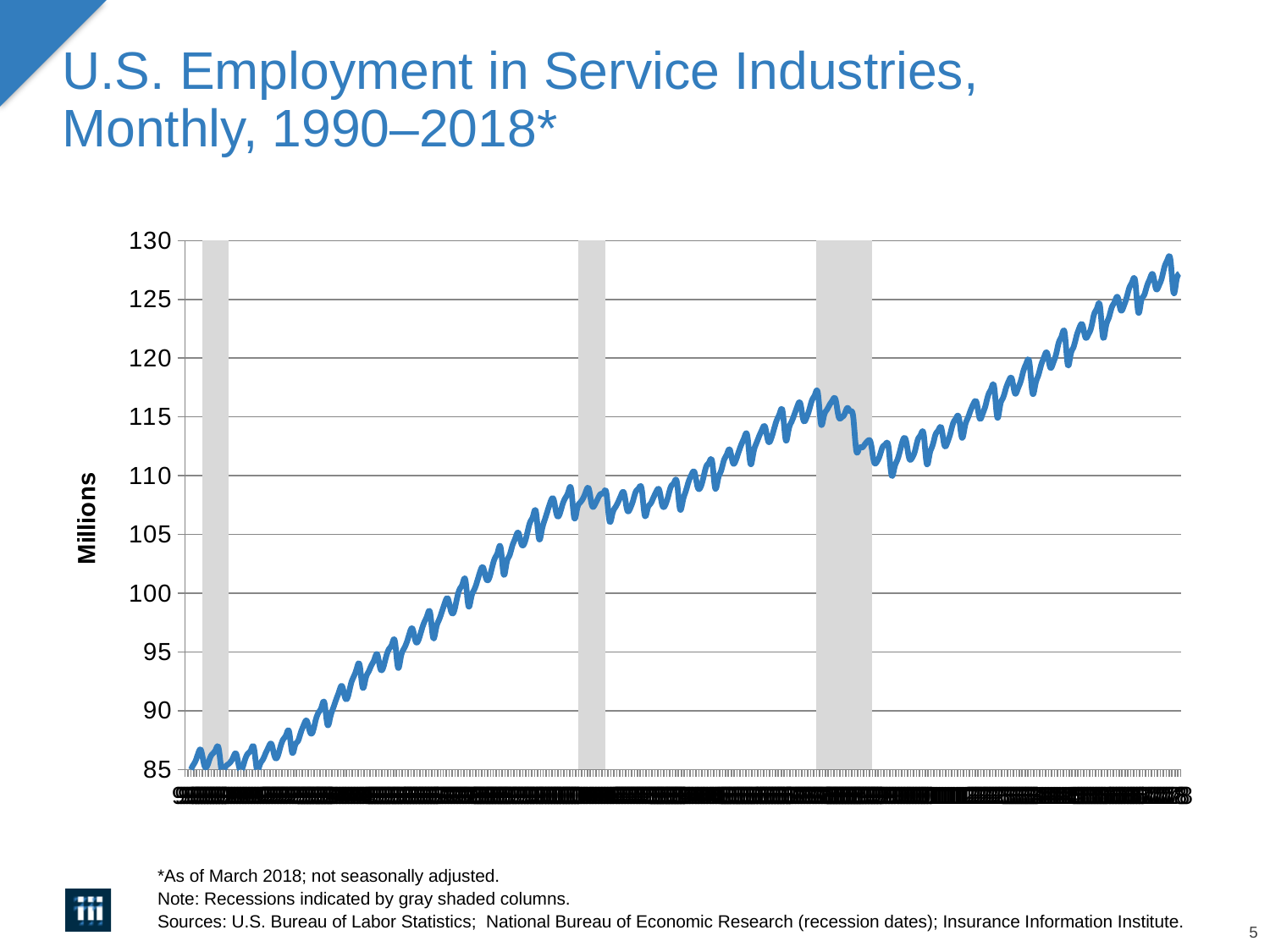
What is the label on the vertical axis of the chart? Millions How many gray shaded recession columns are shown on the chart? 3 Do the values in the chart generally rise or fall from left to right over 1990–2018? rise Is the value at the start of the series (1990) greater or less than 90? less Is the lowest point of the line greater or less than 90? less Is the value at the end of the series (2018) greater or less than 125? greater What is the highest tick value shown on the vertical axis? 130 What is the lowest tick value shown on the vertical axis? 85 What kind of chart is shown on the slide? line chart